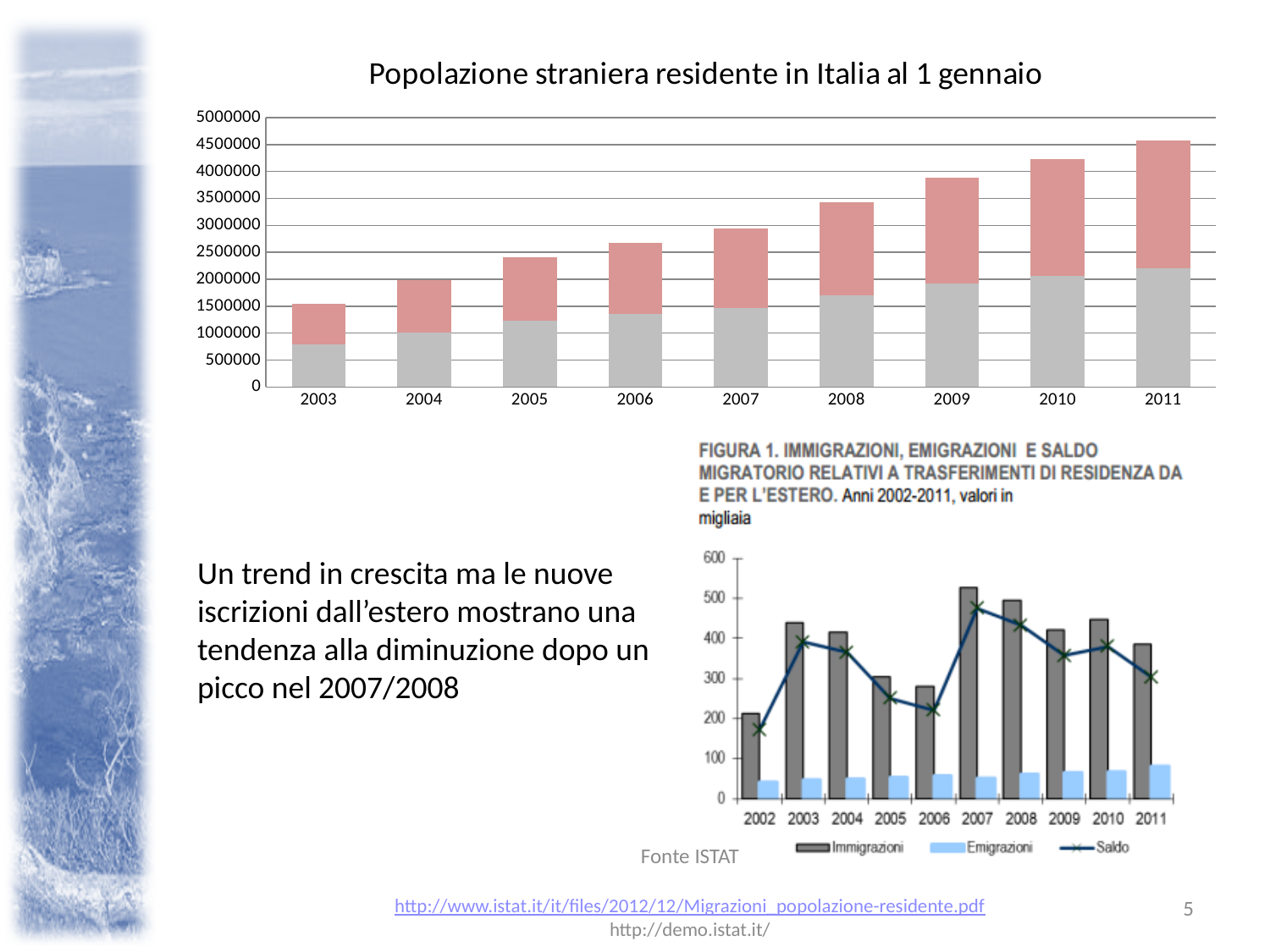
In the top chart 'Popolazione straniera residente in Italia al 1 gennaio', how many years are shown on the x axis? 9 In the bottom chart (Figura 1), which is larger in 2002, Immigrazioni or Emigrazioni? Immigrazioni In the bottom chart (Figura 1), how many series does the legend list? 3 In the top chart 'Popolazione straniera residente in Italia al 1 gennaio', is the total bar for 2003 greater or less than 2000000? less In the bottom chart (Figura 1), in which year is the Immigrazioni bar highest? 2007 In the top chart 'Popolazione straniera residente in Italia al 1 gennaio', is the total bar for 2006 greater or less than 2500000? greater In the top chart 'Popolazione straniera residente in Italia al 1 gennaio', which year has the tallest stacked bar? 2011 In the top chart 'Popolazione straniera residente in Italia al 1 gennaio', do the stacked bar totals rise or fall from 2003 to 2011? rise In the top chart 'Popolazione straniera residente in Italia al 1 gennaio', is the total bar for 2010 greater or less than 4000000? greater In the top chart 'Popolazione straniera residente in Italia al 1 gennaio', which year has the shortest stacked bar? 2003 What kind of chart is the top chart titled 'Popolazione straniera residente in Italia al 1 gennaio'? stacked bar chart